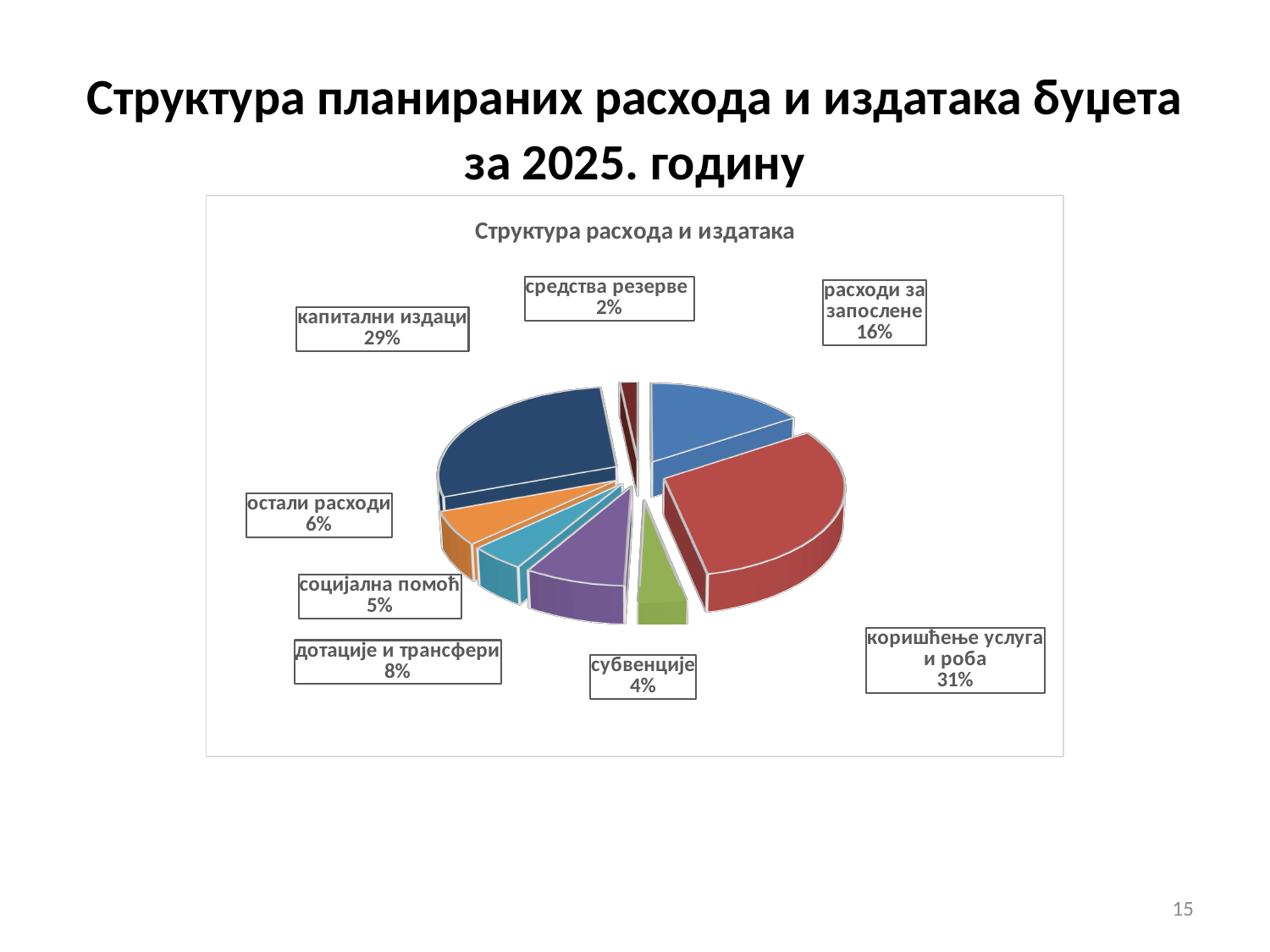
What share of the pie is капитални издаци? 29% What is the value shown for средства резерве? 2% What is the value shown for субвенције? 4% What kind of chart is shown on the slide? Pie chart Which category has the smallest share of the pie? средства резерве What is the difference between the shares of коришћење услуга и роба and расходи за запослене? 15% How many categories (slices) does the pie chart have? 8 What is the title of the chart? Структура расхода и издатака What share of the pie is коришћење услуга и роба? 31% Which is larger, the share for дотације и трансфери or the share for социјална помоћ? дотације и трансфери Which category has the largest share of the pie? коришћење услуга и роба What is the value shown for расходи за запослене? 16%